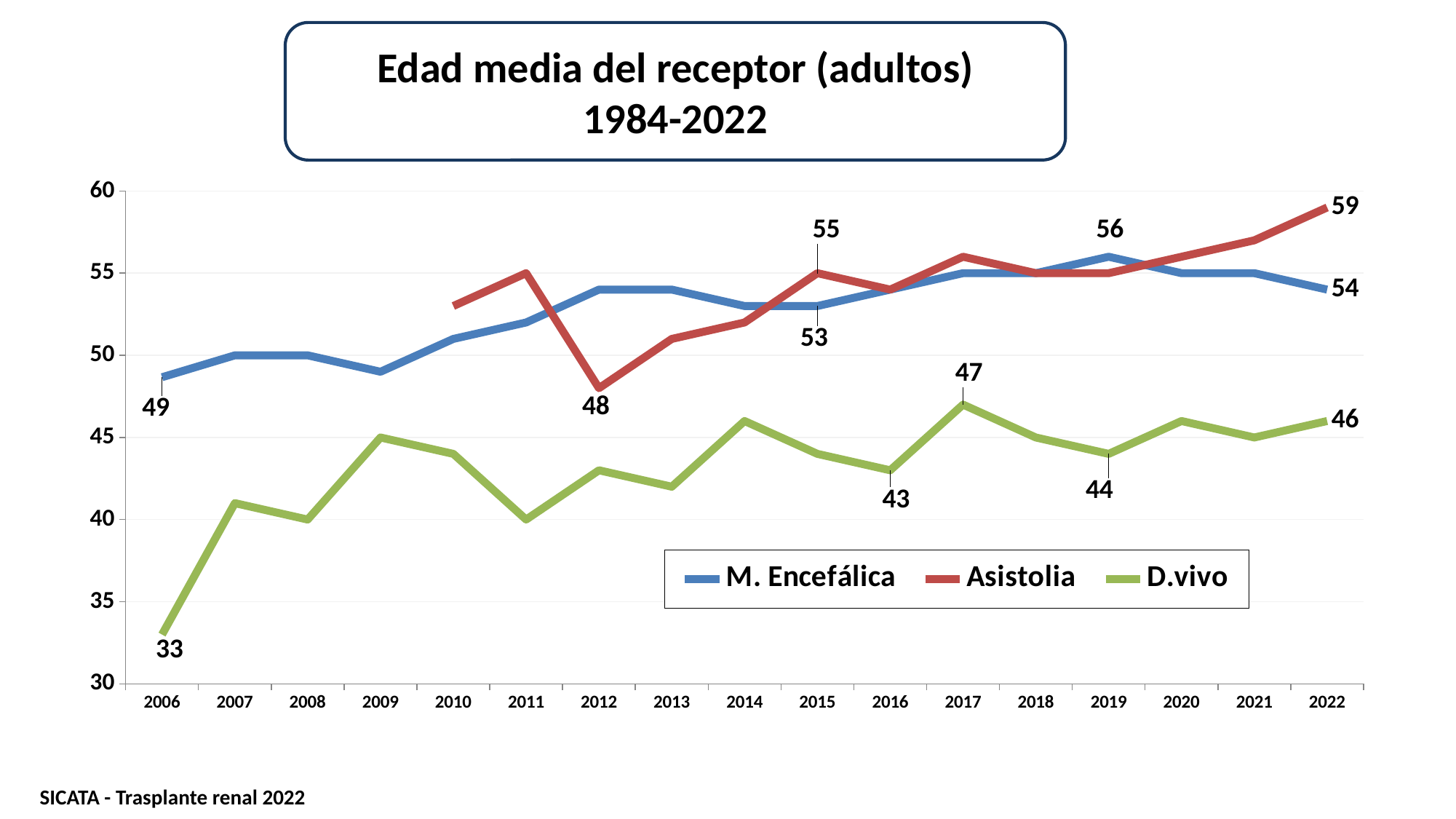
What is the value for Asistolia in 2022? 59 How many series does the legend list? 3 What is the value for D.vivo in 2017? 47 Is the value for D.vivo in 2011 greater or less than 45? less What is the value for M. Encefálica in 2022? 54 What kind of chart is shown on the slide? line chart What is the value for Asistolia in 2012? 48 What is the difference between the Asistolia and M. Encefálica values in 2022? 5 In 2015, which is larger: the Asistolia value or the M. Encefálica value? Asistolia What is the value for D.vivo in 2006? 33 By how much did the D.vivo value increase from 2006 to 2022? 13 How many years are shown on the x axis? 17